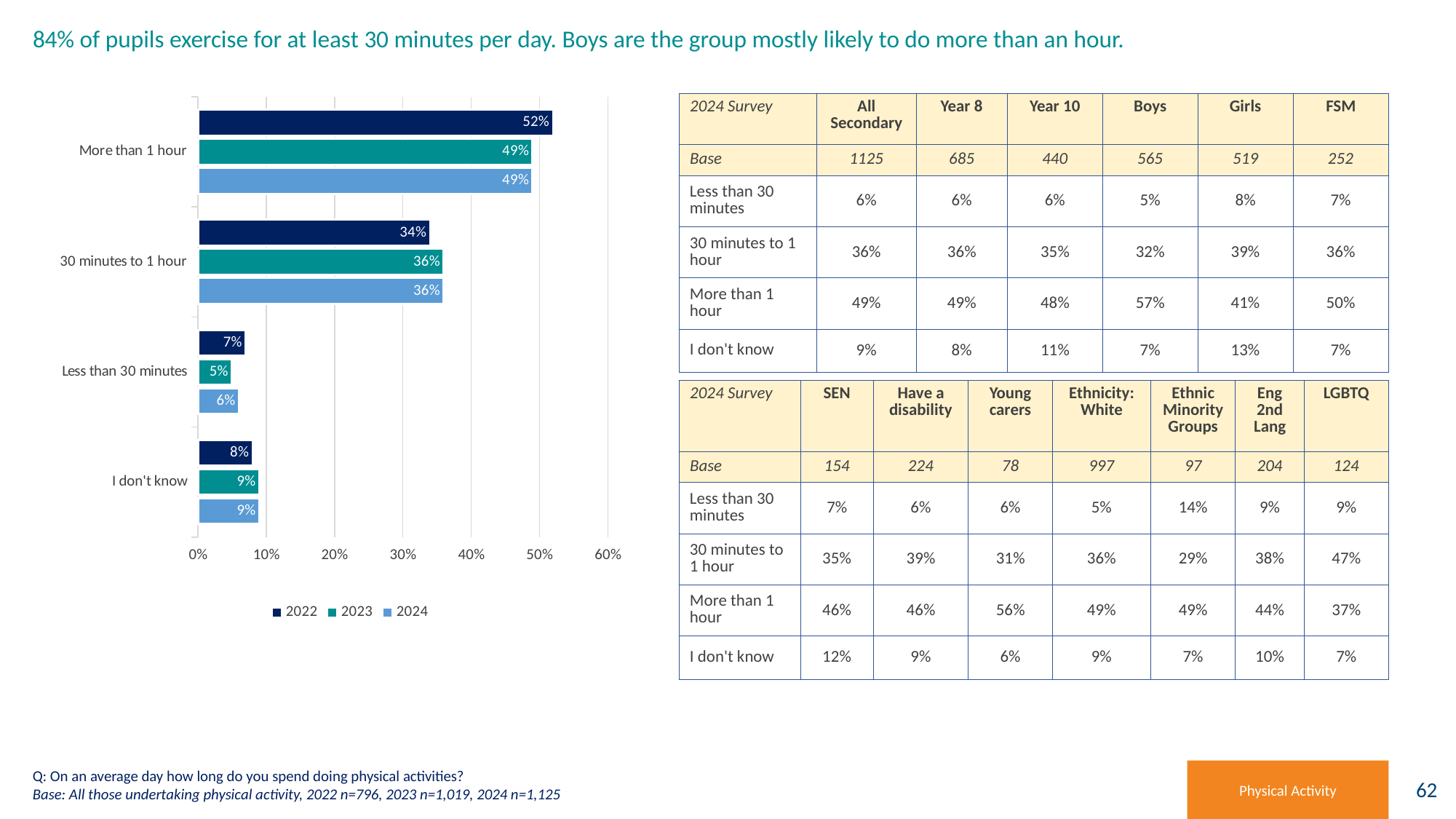
How many series does the legend of the bar chart list? 3 What kind of chart is shown on the slide? bar chart What is the 2022 value for '30 minutes to 1 hour' in the bar chart? 34% In the bar chart, is the 2022 value for 'I don't know' larger or smaller than the 2023 value? smaller How many categories are shown on the bar chart? 4 Is the 2022 value for 'More than 1 hour' in the bar chart greater or less than 50%? greater Which years are listed in the legend of the bar chart? 2022, 2023, 2024 What is the 2023 value for 'Less than 30 minutes' in the bar chart? 5% What is the difference between the 2022 and 2024 values for 'More than 1 hour' in the bar chart? 3% Which category has the lowest value for 2023 in the bar chart? Less than 30 minutes What is the 2024 value for 'More than 1 hour' in the bar chart? 49% Which category has the highest value for 2022 in the bar chart? More than 1 hour